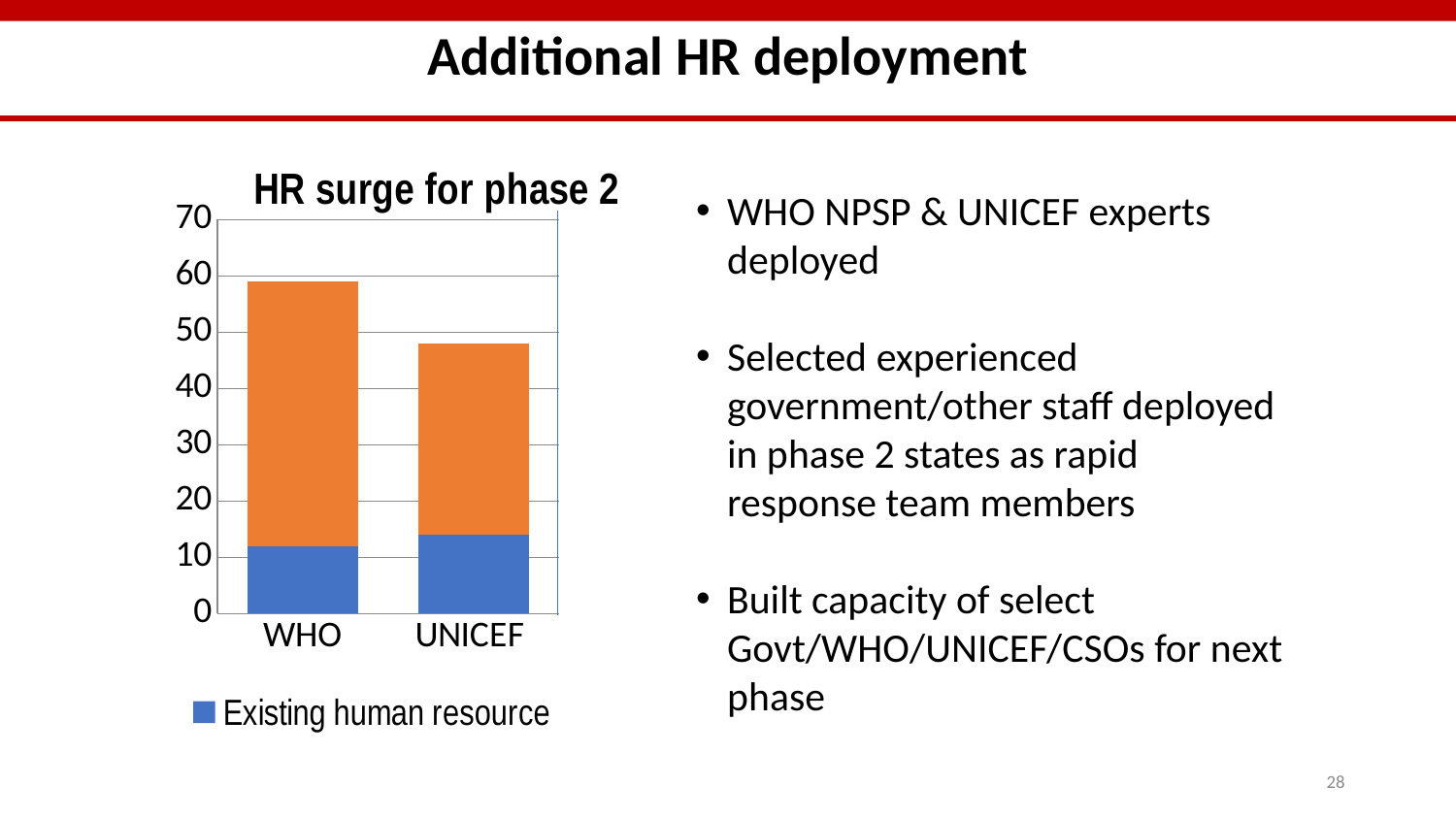
Is the total bar height for UNICEF greater or less than 40? greater Is the total bar height for WHO greater or less than 50? greater Is the total bar height for UNICEF greater or less than 60? less Which category has the highest total bar in the chart? WHO How many categories are shown on the x axis of the chart? 2 Which category has the taller stacked bar, WHO or UNICEF? WHO What type of chart is shown on the slide? Stacked bar chart What series name is shown in the chart's legend? Existing human resource How many series does the chart's legend list? 1 What is the title of the chart? HR surge for phase 2